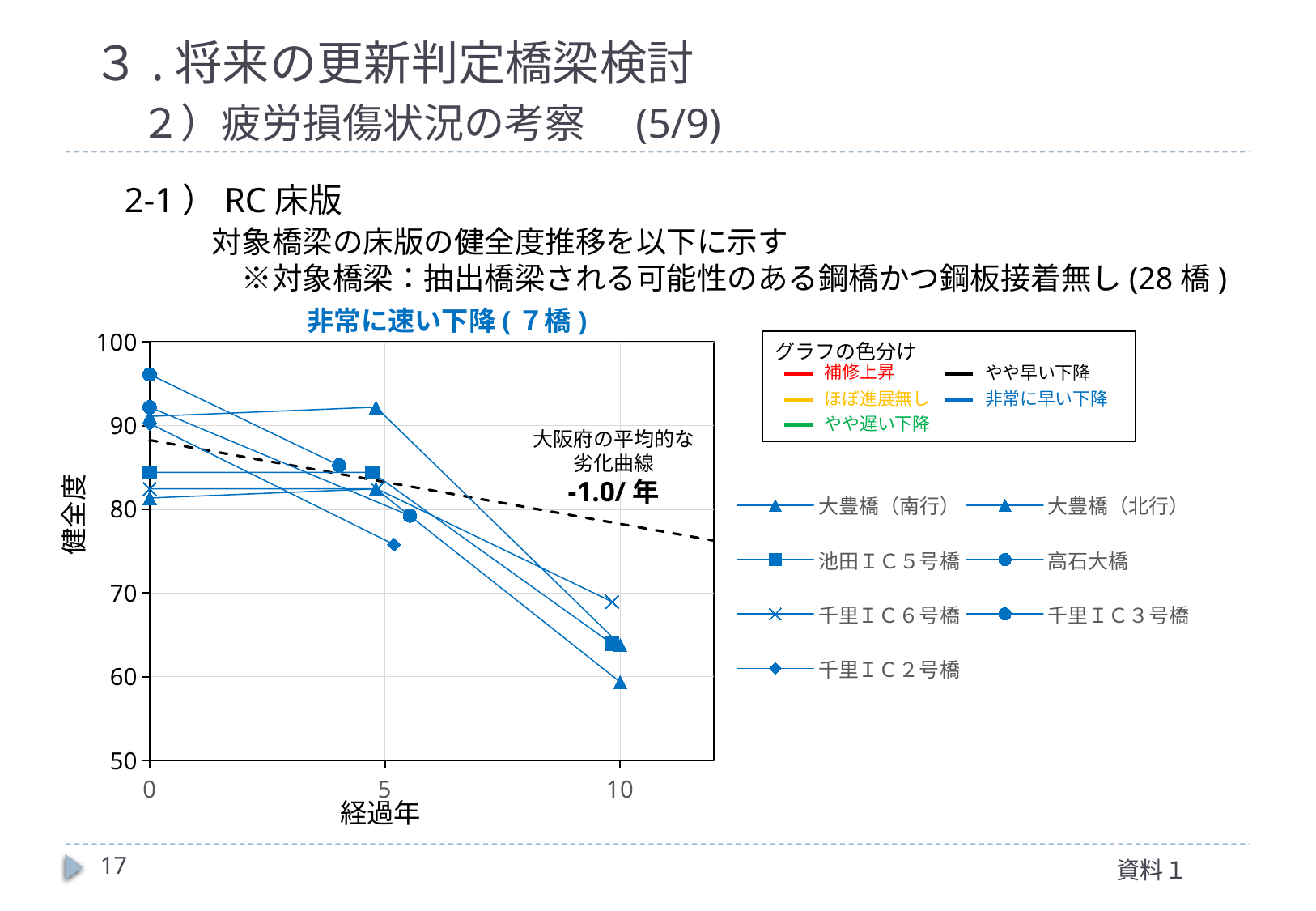
Is the value for 池田ＩＣ５号橋 at 経過年 0 greater or less than 80? greater What is the minimum value shown on the y axis (健全度) of the chart? 50 What is the label of the x axis of the chart? 経過年 Is the value for 千里ＩＣ６号橋 at 経過年 0 greater or less than 80? greater What slope is printed next to the dashed 大阪府の平均的な劣化曲線 line? -1.0/年 What is the maximum value shown on the y axis (健全度) of the chart? 100 Do the plotted values for the bridges generally rise or fall as 経過年 increases? fall What kind of chart is shown on the slide? line chart Is the value for 池田ＩＣ５号橋 at 経過年 10 greater or less than 70? less What is the title of the chart? 非常に速い下降(７橋) How many series does the chart legend list? 7